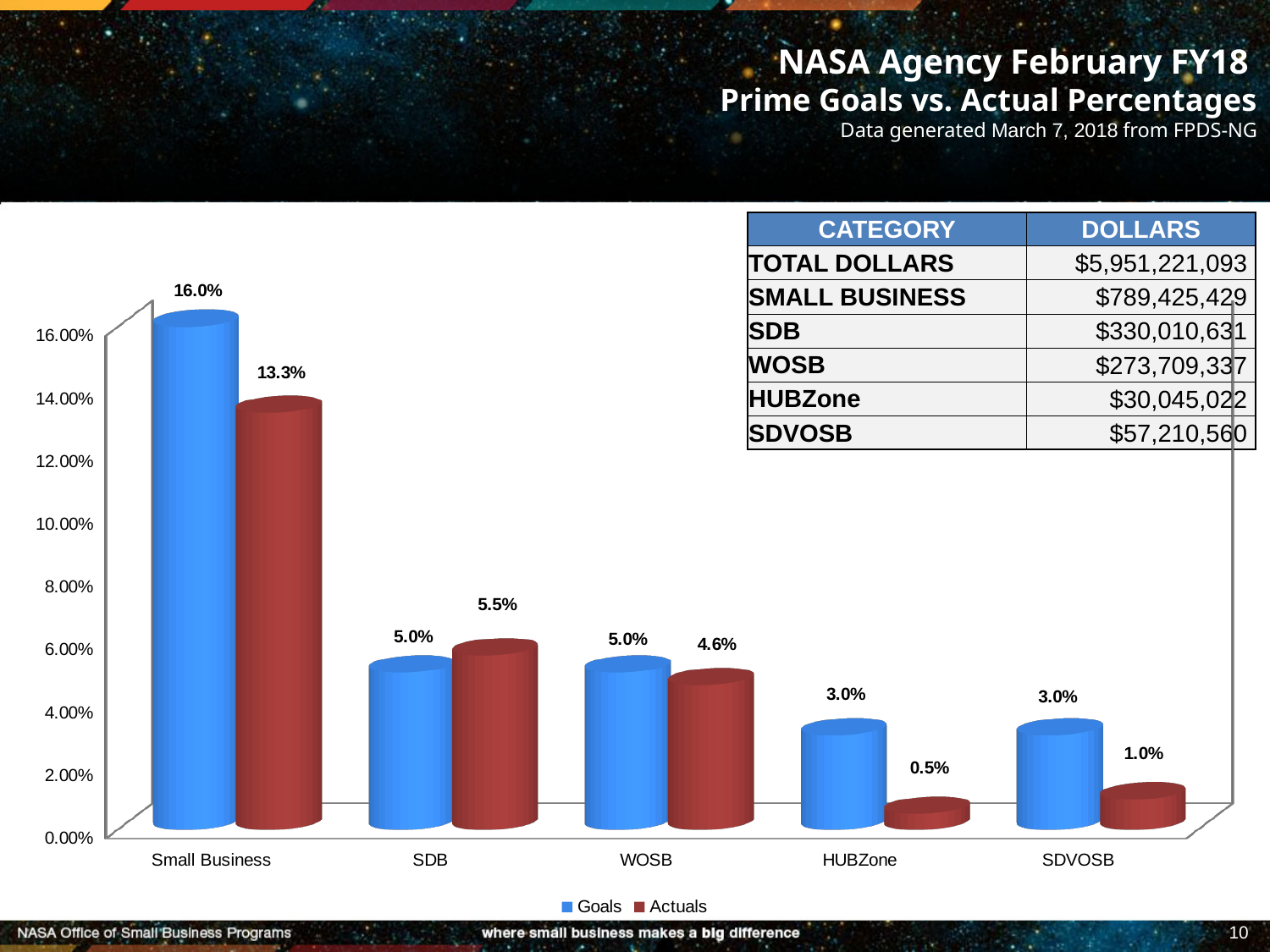
What is the difference between the Goals and Actuals values for Small Business? 2.7% What is the Goals value for SDB? 5.0% How many series does the legend list? 2 What is the Goals value for SDVOSB? 3.0% Which category has the highest Goals value? Small Business How many categories are shown on the x axis? 5 What kind of chart is shown on the slide? Bar chart Which is larger for SDB, the Goals value or the Actuals value? Actuals Which category has the lowest Actuals value? HUBZone What is the Actuals value for HUBZone? 0.5% What is the Actuals value for Small Business? 13.3% Which series is shown in red in the legend? Actuals